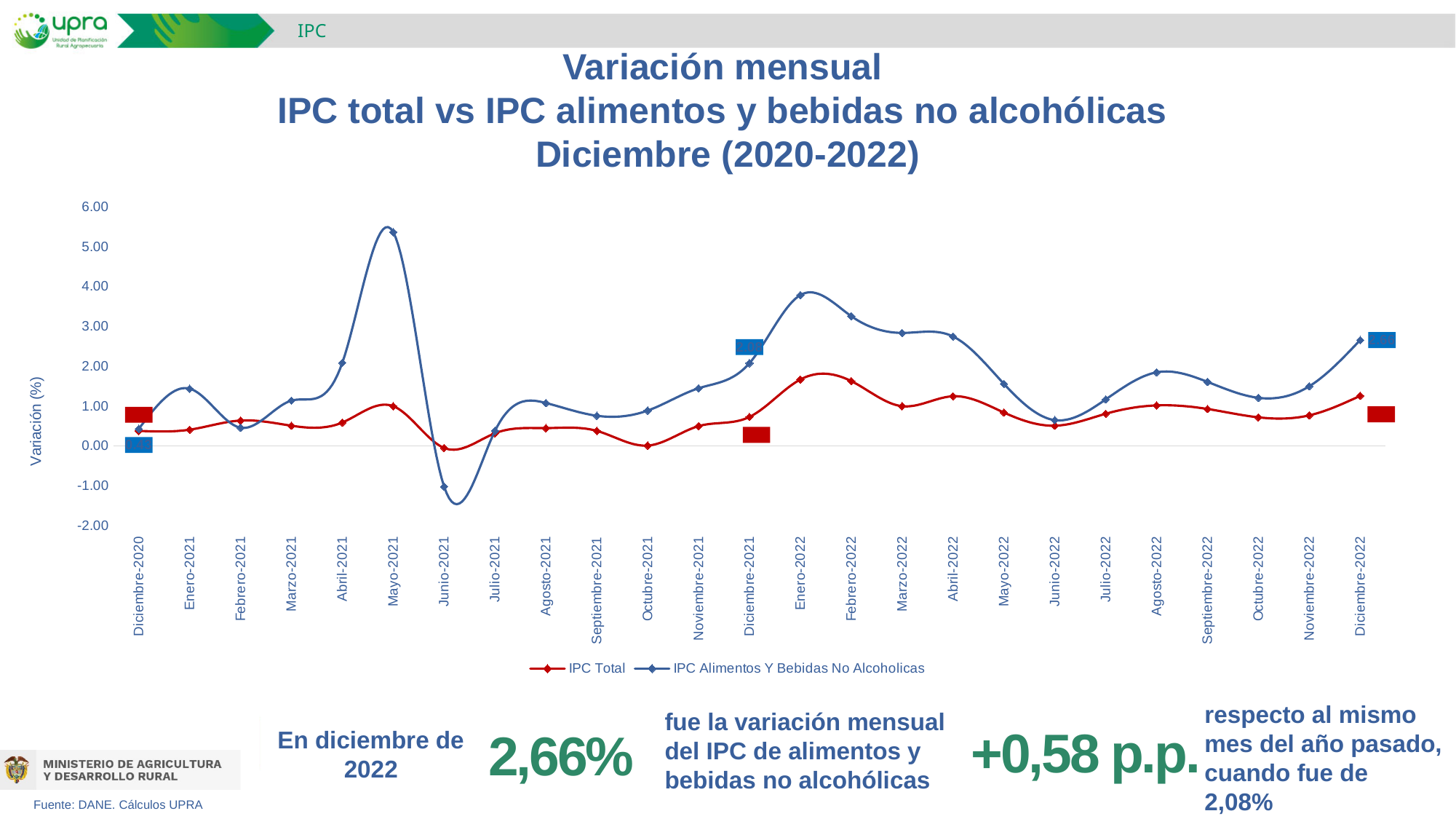
In which month does the IPC Alimentos Y Bebidas No Alcoholicas series reach its lowest value? Junio-2021 What are the two series named in the legend? IPC Total and IPC Alimentos Y Bebidas No Alcoholicas What was the monthly variation of IPC alimentos y bebidas no alcohólicas in Diciembre-2021? 2,08% How many series does the legend list? 2 What was the monthly variation of IPC alimentos y bebidas no alcohólicas in Diciembre-2022? 2,66% What kind of chart is shown on the slide? line chart In Mayo-2021, which series has the larger value, IPC Total or IPC Alimentos Y Bebidas No Alcoholicas? IPC Alimentos Y Bebidas No Alcoholicas How many months are plotted along the x axis? 25 By how many percentage points did the IPC alimentos y bebidas no alcohólicas variation in Diciembre-2022 differ from Diciembre-2021? +0,58 p.p. Is the value for IPC Alimentos Y Bebidas No Alcoholicas in Junio-2021 greater or less than 0.00? less Is the value for IPC Alimentos Y Bebidas No Alcoholicas in Mayo-2021 greater or less than 5.00? greater In which month does the IPC Alimentos Y Bebidas No Alcoholicas series reach its highest value? Mayo-2021